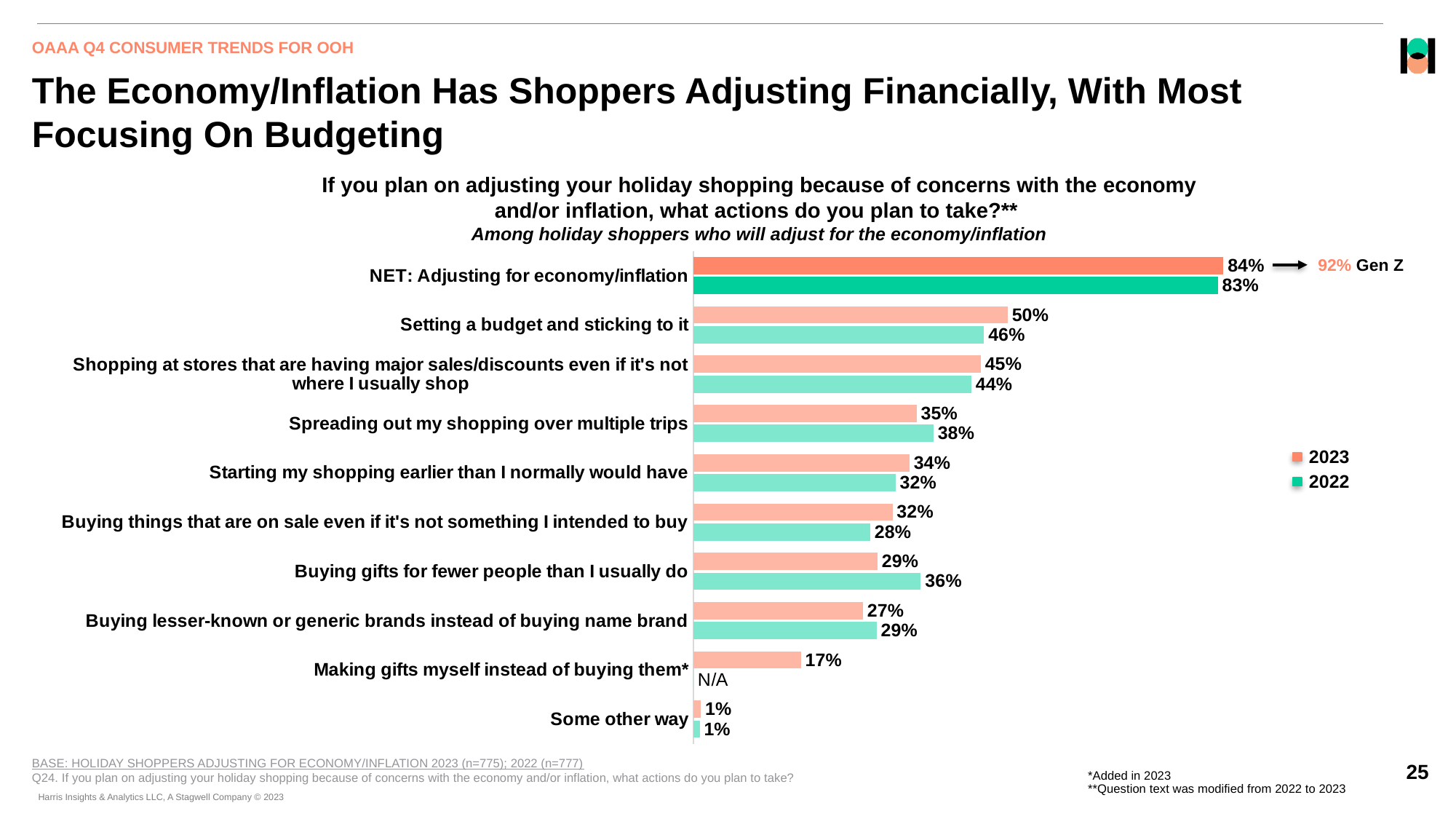
What is the 2022 value for "Making gifts myself instead of buying them*"? N/A How many series does the legend list? 2 What kind of chart is shown on the slide? Bar chart How many categories are shown on the chart? 10 What is the 2023 value for "NET: Adjusting for economy/inflation"? 84% What is the difference between the 2023 and 2022 values for "Buying gifts for fewer people than I usually do"? 7% Excluding the NET row, which action has the highest 2023 value? Setting a budget and sticking to it What is the 2022 value for "Buying gifts for fewer people than I usually do"? 36% For "Spreading out my shopping over multiple trips", which year has the larger value, 2023 or 2022? 2022 What Gen Z value is called out next to the NET bar? 92% What is the 2023 value for "Setting a budget and sticking to it"? 50% Which category has the lowest 2023 value? Some other way